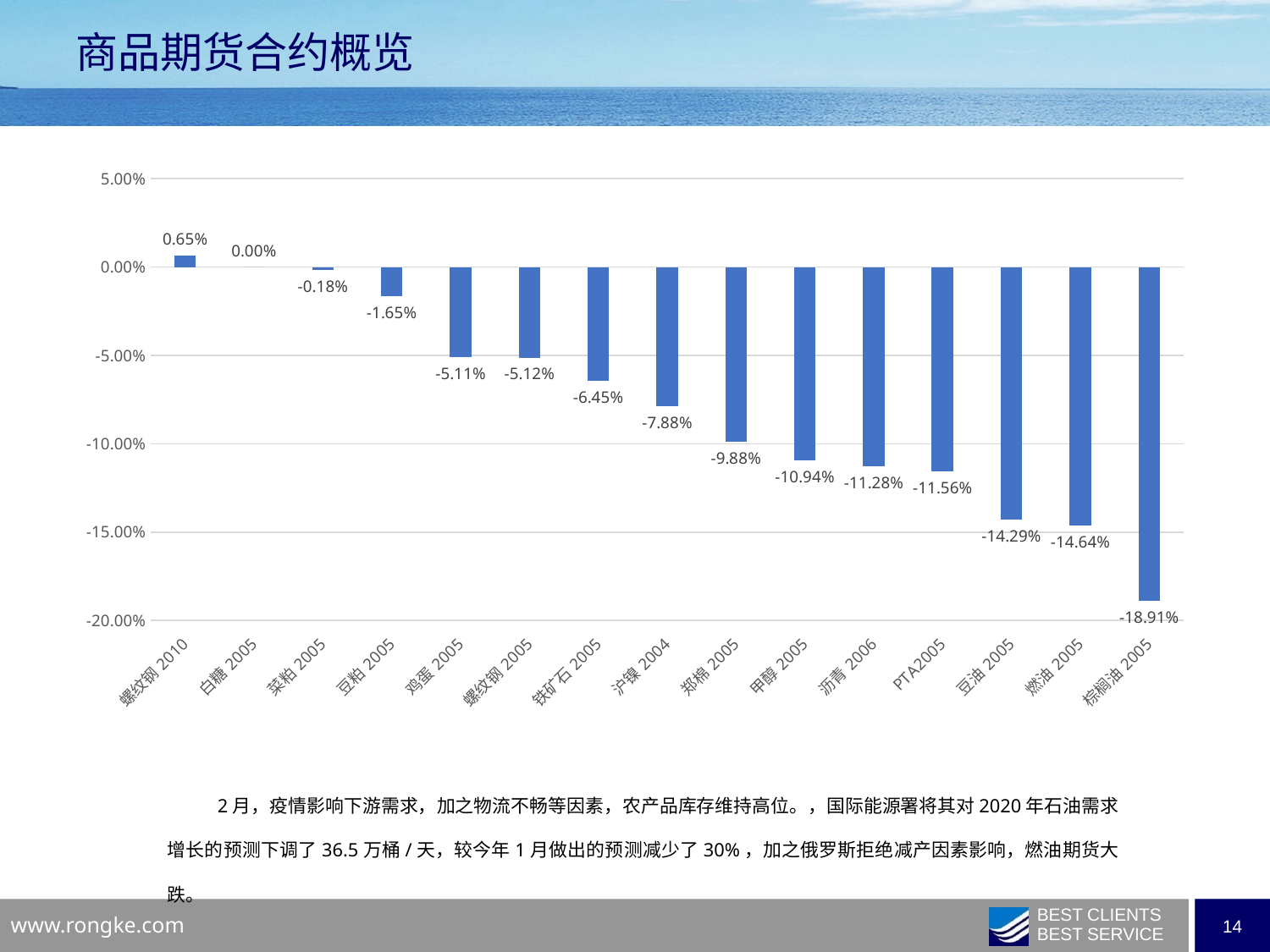
What is the value for 甲醇 2005? -10.94% What is the value for 螺纹钢 2010? 0.65% Which category has the highest value? 螺纹钢 2010 Do the values generally rise or fall from left to right along the x axis? fall What is the difference between the values for 燃油 2005 and 豆油 2005? 0.35% How many categories are shown on the x axis? 15 Which category has the lowest value? 棕榈油 2005 What kind of chart is shown on the slide? bar chart What is the value for 棕榈油 2005? -18.91% What is the value for 铁矿石 2005? -6.45% Is the value for 沥青 2006 greater or less than -10.00%? less Which is larger, the value for 沪镍 2004 or the value for 郑棉 2005? 沪镍 2004